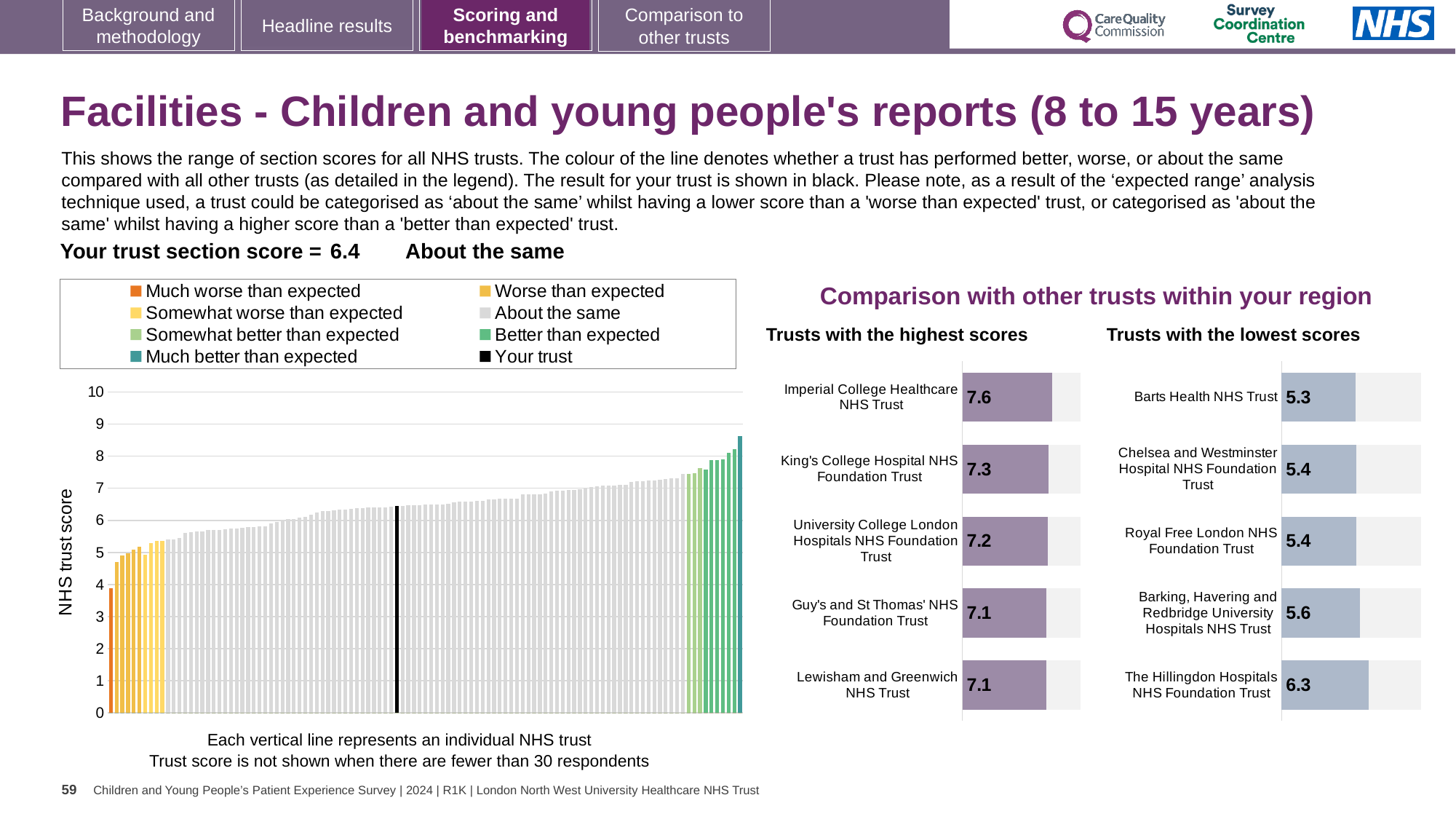
In the 'Trusts with the lowest scores' chart, which trust has the highest score? The Hillingdon Hospitals NHS Foundation Trust In the 'Trusts with the highest scores' chart, what is the difference between the scores of Imperial College Healthcare NHS Trust and King's College Hospital NHS Foundation Trust? 0.3 In the 'Trusts with the lowest scores' chart, which has the larger score: Barking, Havering and Redbridge University Hospitals NHS Trust or Barts Health NHS Trust? Barking, Havering and Redbridge University Hospitals NHS Trust In the 'Trusts with the highest scores' chart, what is the score for Imperial College Healthcare NHS Trust? 7.6 What kind of chart is the main chart on the left showing all NHS trusts? Bar chart In the 'Trusts with the lowest scores' chart, what is the difference between the scores of The Hillingdon Hospitals NHS Foundation Trust and Barts Health NHS Trust? 1.0 In the main chart on the left, how many entries does the legend list? 8 In the 'Trusts with the lowest scores' chart, which trust has the lowest score? Barts Health NHS Trust In the 'Trusts with the highest scores' chart, which trust has the highest score? Imperial College Healthcare NHS Trust In the 'Trusts with the highest scores' chart, how many trusts are listed? 5 In the 'Trusts with the lowest scores' chart, what is the score for Barts Health NHS Trust? 5.3 In the main chart on the left, is the value for the black 'Your trust' bar greater or less than 6? greater